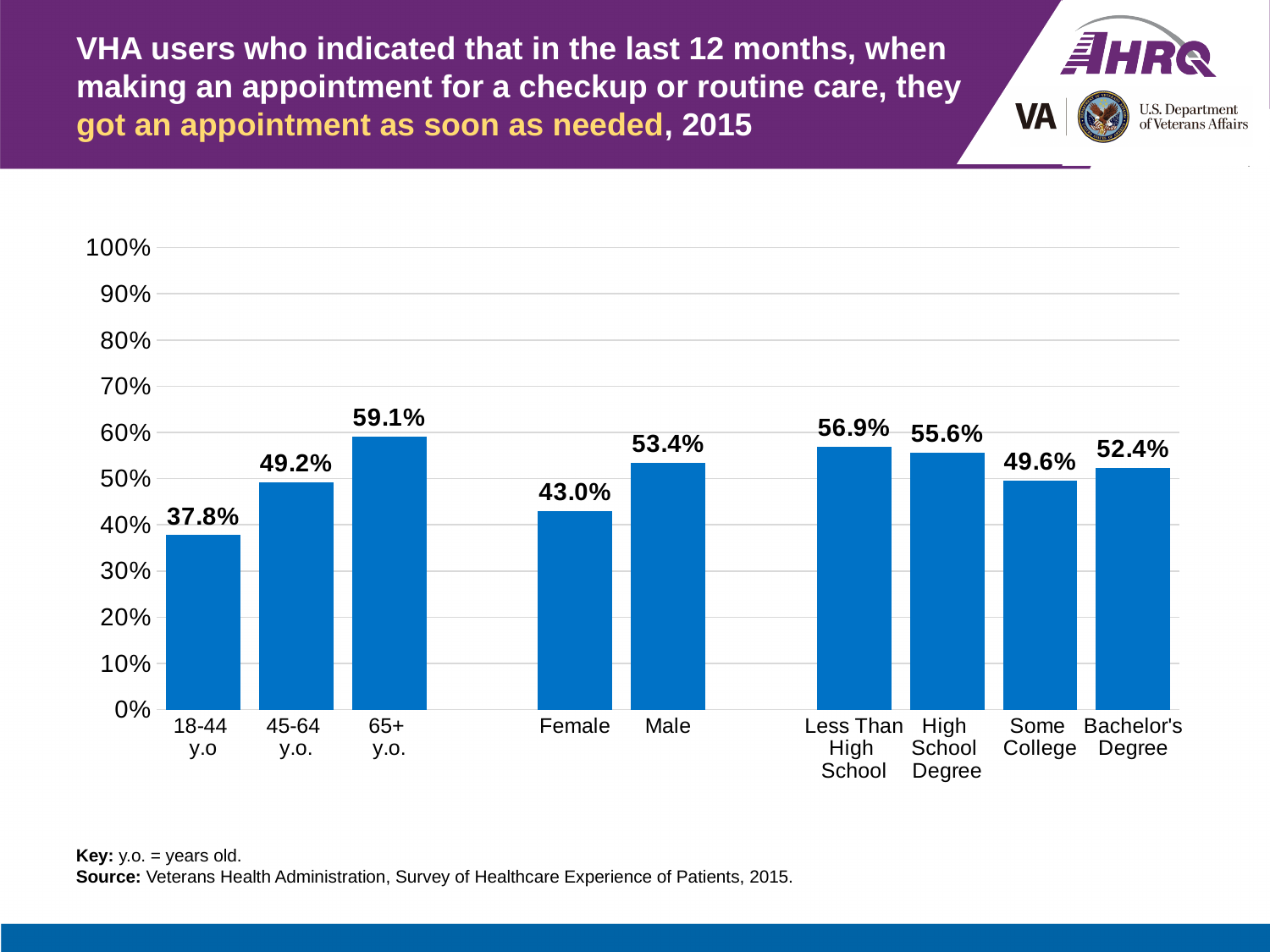
What percentage of VHA users aged 65+ y.o. got an appointment as soon as needed? 59.1% How many categories (bars) are shown on the chart? 9 What is the value shown for Female VHA users? 43.0% Which is larger, the value for 45-64 y.o. or the value for Bachelor's Degree? Bachelor's Degree What is the difference between the values for Less Than High School and High School Degree? 1.3% Which category has the highest value on the chart? 65+ y.o. Is the value for 18-44 y.o greater or less than 40%? less What kind of chart is shown on the slide? Bar chart Which category has the lowest value on the chart? 18-44 y.o What is the value shown for VHA users with Some College? 49.6% What is the difference between the Male and Female values? 10.4% Do the values rise or fall across the three age groups from 18-44 y.o to 65+ y.o.? Rise